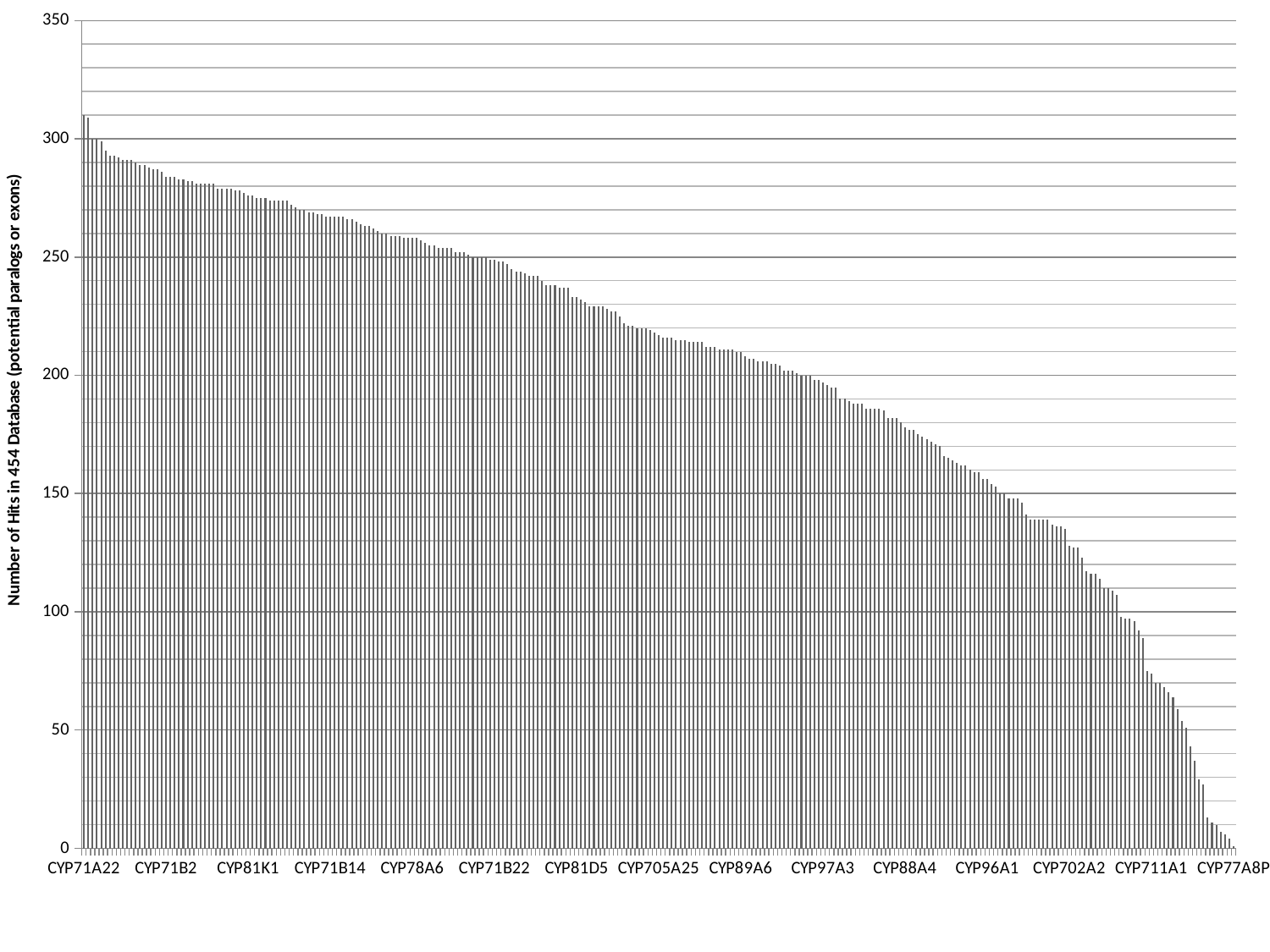
Is the value for CYP77A8P greater or less than 50? less Is the value for CYP71B14 greater or less than 250? greater What is the title of the vertical axis? Number of Hits in 454 Database (potential paralogs or exons) Is the value for CYP81D5 greater or less than 250? less Do the values rise or fall moving from left to right along the x axis? fall What kind of chart is shown on the slide? bar chart Which has the larger value, CYP71B2 or CYP702A2? CYP71B2 Which labelled category has the lowest value? CYP77A8P Which labelled category has the highest value? CYP71A22